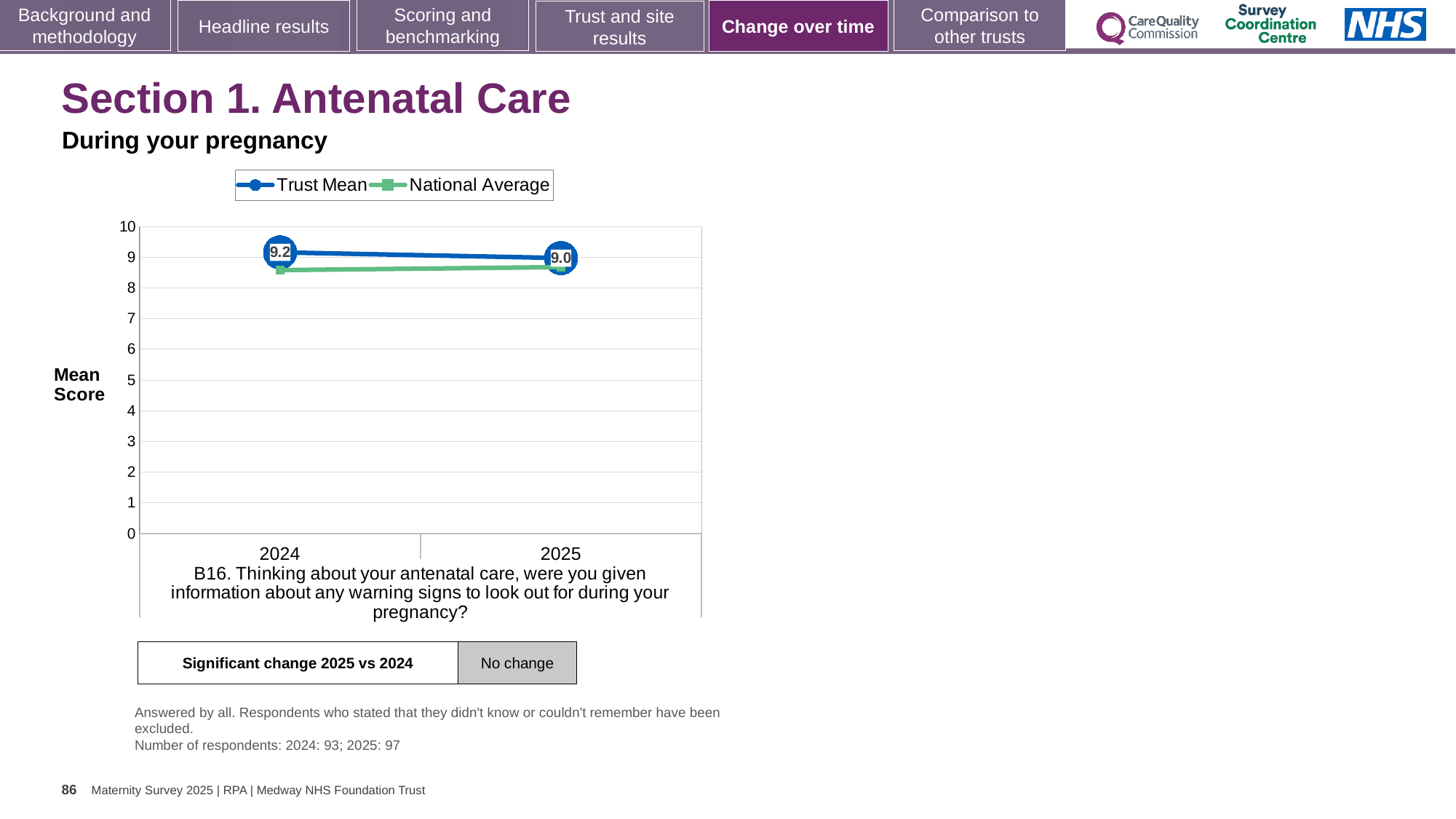
What is the difference between the Trust Mean scores for 2024 and 2025? 0.2 In which year is the Trust Mean score lower? 2025 How many years are plotted on the x axis? 2 What is the Trust Mean score for 2025? 9.0 In 2024, which is larger, the Trust Mean or the National Average? Trust Mean In which year is the Trust Mean score higher? 2024 Is the National Average value for 2024 greater or less than 8? greater Is the National Average value for 2025 greater or less than 9? less What is the Trust Mean score for 2024? 9.2 Does the Trust Mean rise or fall from 2024 to 2025? fall How many series does the legend list? 2 What kind of chart is shown on the slide? line chart